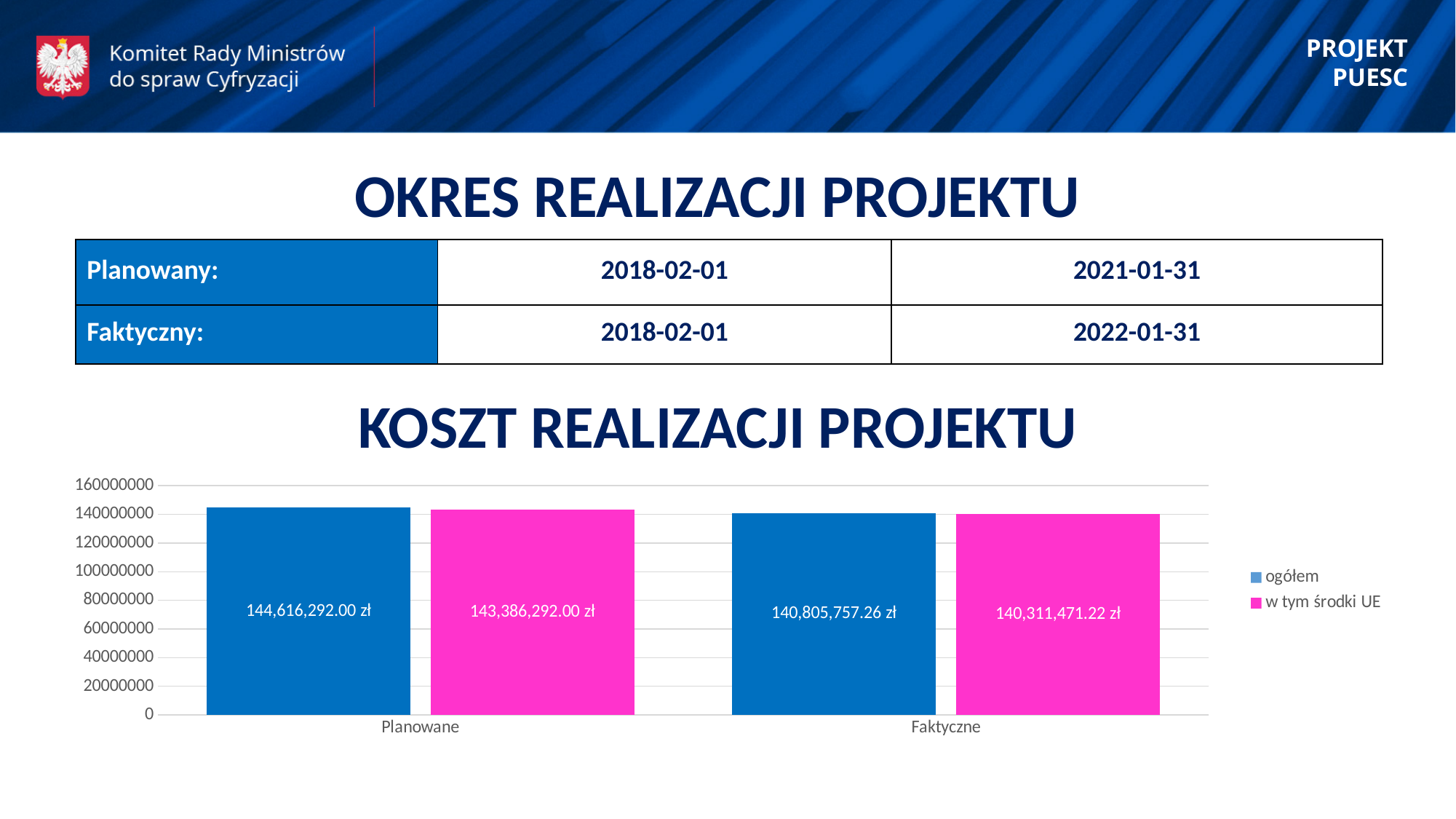
What type of chart is shown under 'KOSZT REALIZACJI PROJEKTU'? Bar chart What is the difference between the 'ogółem' and 'w tym środki UE' values for Planowane? 1,230,000.00 zł What is the value of the 'w tym środki UE' bar for Faktyczne? 140,311,471.22 zł What is the value of the 'ogółem' bar for Planowane? 144,616,292.00 zł How many series does the legend list? 2 What is the difference between the 'ogółem' values for Planowane and Faktyczne? 3,810,534.74 zł Which is larger: the 'w tym środki UE' value for Planowane or for Faktyczne? Planowane Which bar has the highest value in the chart? Planowane, ogółem Is the 'ogółem' value for Faktyczne greater or less than 120000000? greater Which bar has the lowest value in the chart? Faktyczne, w tym środki UE What is the value of the 'ogółem' bar for Faktyczne? 140,805,757.26 zł How many categories are shown on the x axis? 2